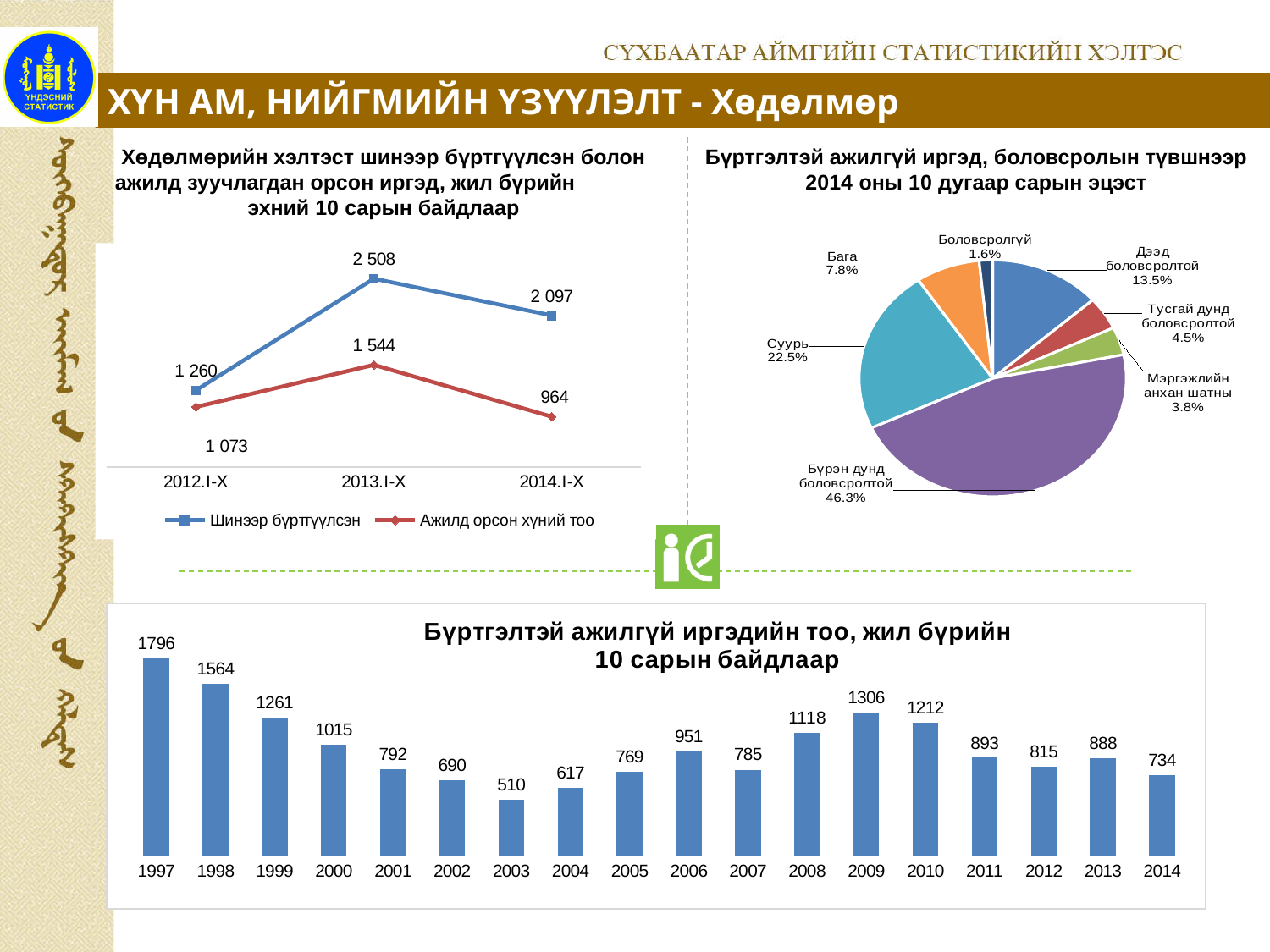
In the top-right pie chart, what share is Бүрэн дунд боловсролтой? 46.3% In the bottom bar chart (Бүртгэлтэй ажилгүй иргэдийн тоо), what is the difference between the values for 1997 and 2014? 1062 In the top-left line chart, what is the value of Ажилд орсон хүний тоо for 2014.I-X? 964 In the top-right pie chart, which category has the smallest share? Боловсролгүй In the bottom bar chart (Бүртгэлтэй ажилгүй иргэдийн тоо), which year has the lowest value? 2003 What kind of chart is the bottom chart (Бүртгэлтэй ажилгүй иргэдийн тоо)? Bar chart In the bottom bar chart (Бүртгэлтэй ажилгүй иргэдийн тоо), what is the value for 2009? 1306 In the top-left line chart, which is larger for 2012.I-X: Шинээр бүртгүүлсэн or Ажилд орсон хүний тоо? Шинээр бүртгүүлсэн In the top-left line chart, how many series does the legend list? 2 In the bottom bar chart (Бүртгэлтэй ажилгүй иргэдийн тоо), which year has the highest value? 1997 In the bottom bar chart (Бүртгэлтэй ажилгүй иргэдийн тоо), how many years are shown? 18 In the top-left line chart, what is the value of Шинээр бүртгүүлсэн for 2013.I-X? 2 508